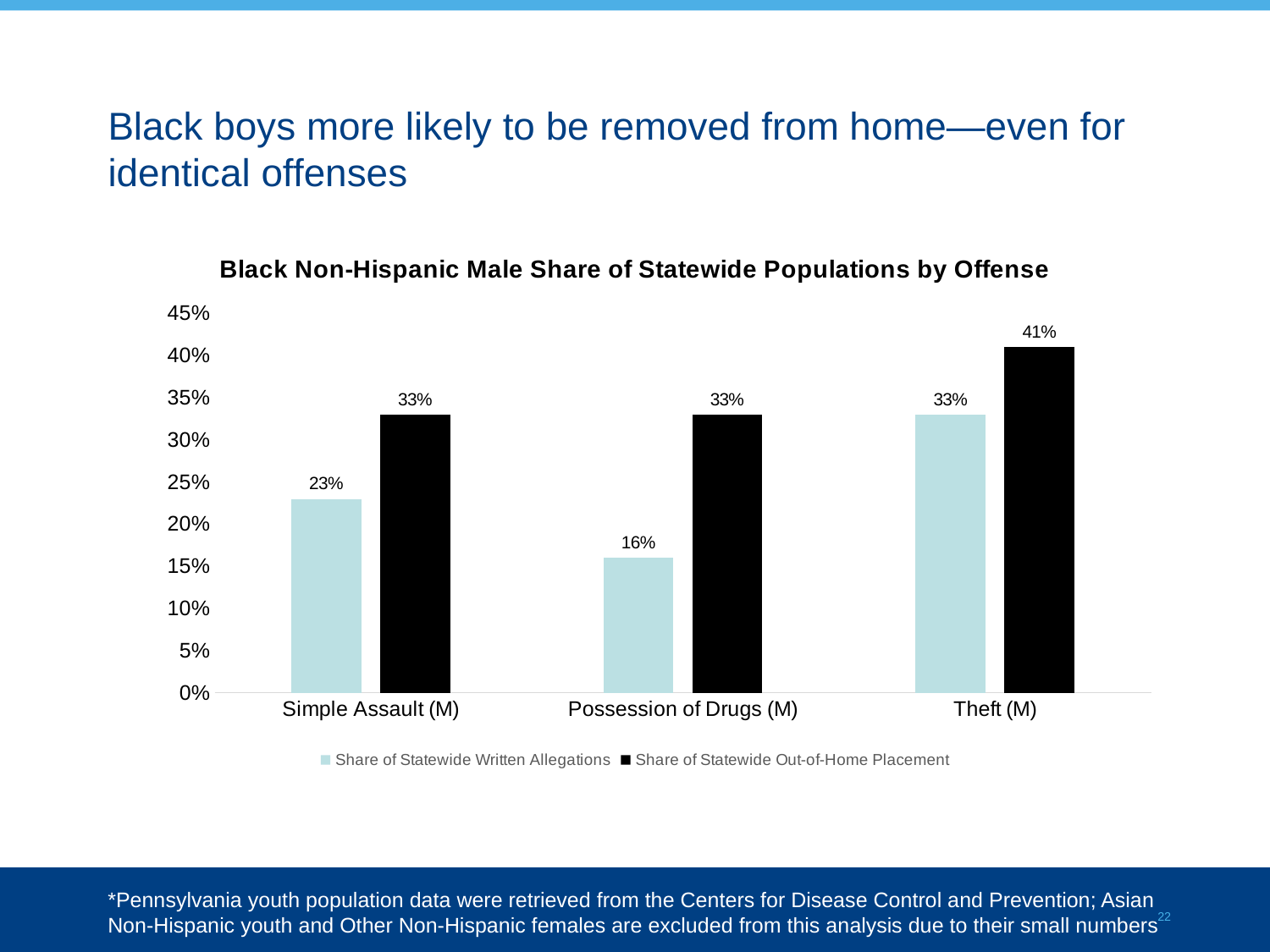
What is the Share of Statewide Written Allegations for Possession of Drugs (M)? 16% How many offense categories are shown on the x axis? 3 Which is larger for Simple Assault (M): the Share of Statewide Written Allegations or the Share of Statewide Out-of-Home Placement? Share of Statewide Out-of-Home Placement What is the title of the chart? Black Non-Hispanic Male Share of Statewide Populations by Offense What is the Share of Statewide Out-of-Home Placement for Theft (M)? 41% How many series does the legend list? 2 Which offense has the lowest Share of Statewide Written Allegations? Possession of Drugs (M) What is the difference between the Share of Statewide Out-of-Home Placement and the Share of Statewide Written Allegations for Possession of Drugs (M)? 17% What is the Share of Statewide Written Allegations for Simple Assault (M)? 23% What is the difference between the Share of Statewide Out-of-Home Placement and the Share of Statewide Written Allegations for Theft (M)? 8% Which offense has the highest Share of Statewide Out-of-Home Placement? Theft (M) What kind of chart is shown on the slide? Bar chart